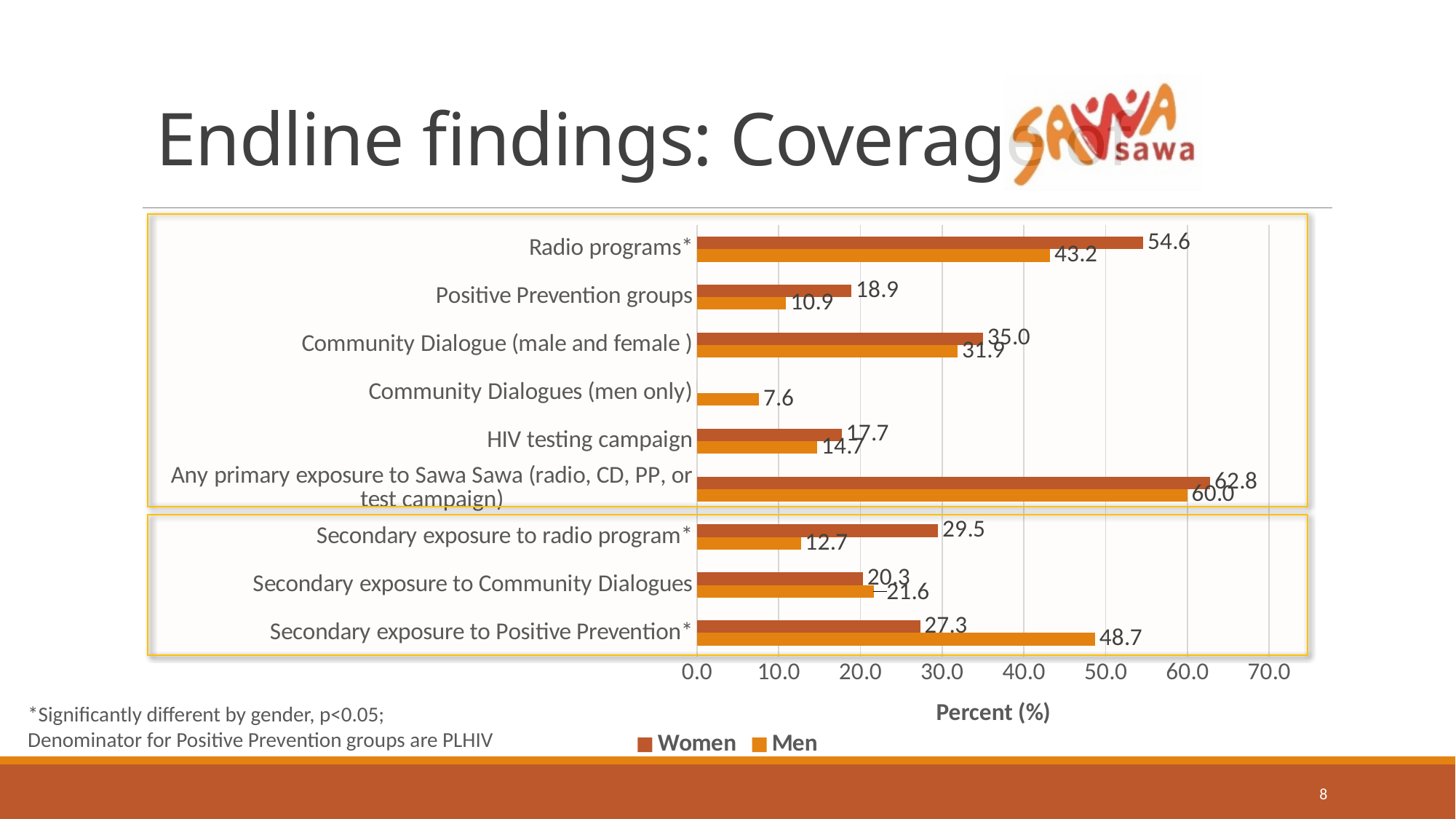
Which category has the highest value for Women? Any primary exposure to Sawa Sawa (radio, CD, PP, or test campaign) What is the value for Men for Secondary exposure to Positive Prevention? 48.7 What kind of chart is shown on the slide? Bar chart What is the value for Men for Community Dialogues (men only)? 7.6 For Secondary exposure to Positive Prevention, which is larger, the Women value or the Men value? Men How many categories are shown on the chart? 9 Is the Men value for Radio programs greater or less than 40.0? greater How many series does the chart legend list? 2 What is the difference between the Women and Men values for Secondary exposure to radio program? 16.8 What is the value for Women for Radio programs? 54.6 Which category has the lowest value for Men? Community Dialogues (men only) What is the label of the horizontal axis? Percent (%)